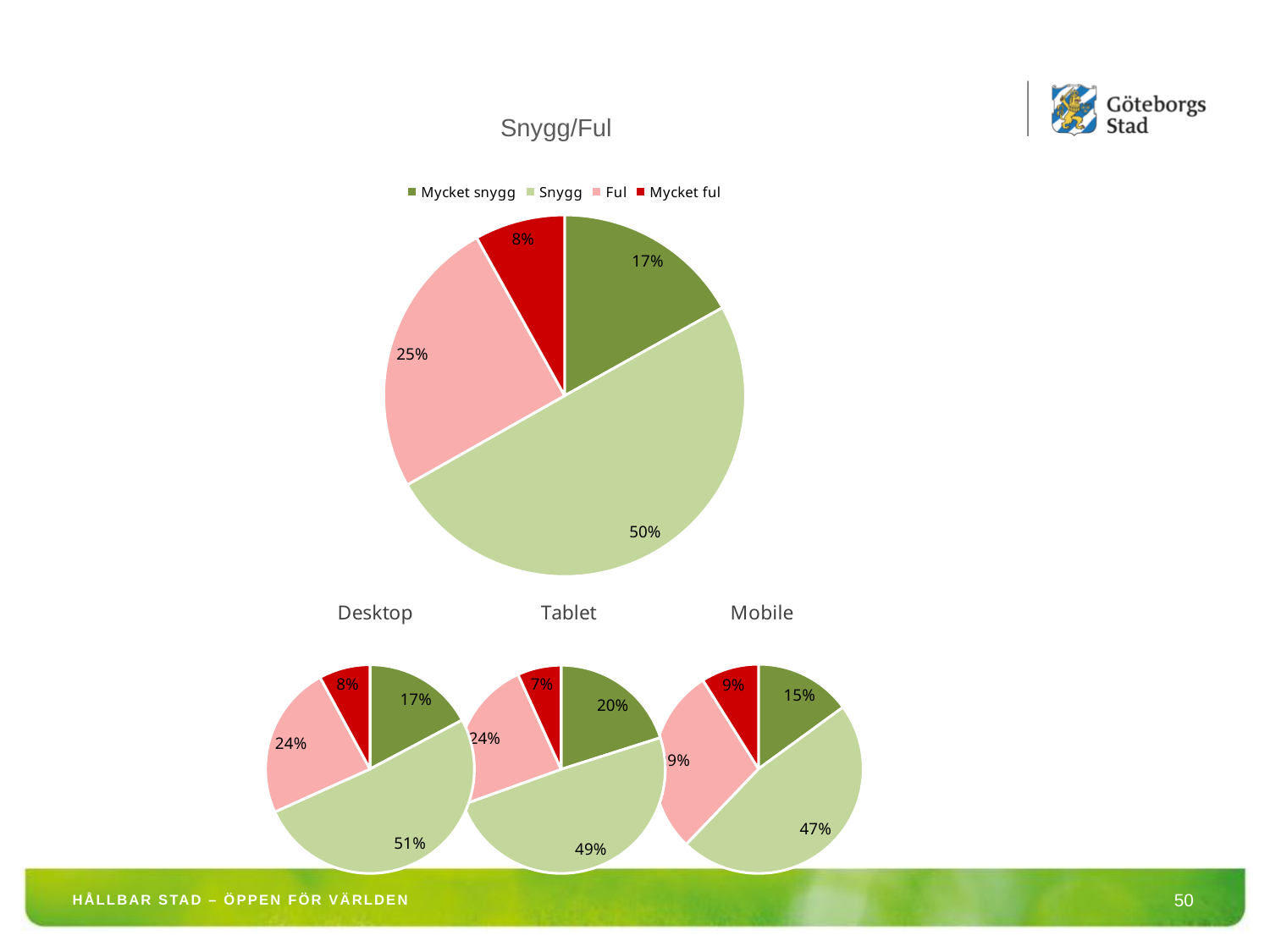
In the Mobile pie chart, what share does the Mycket ful slice have? 9% Which is larger: the Mycket snygg share in the Tablet pie chart or in the Mobile pie chart? Tablet In the main Snygg/Ful pie chart, which category has the smallest share? Mycket ful What kind of chart is the main Snygg/Ful chart? Pie chart In the main Snygg/Ful pie chart, what is the difference between the Ful share and the Mycket snygg share? 8% In the Tablet pie chart, what share does the Mycket snygg slice have? 20% How many categories does the legend of the Snygg/Ful chart list? 4 In the Desktop pie chart, what share does the Snygg slice have? 51% In the main Snygg/Ful pie chart, which category has the largest share? Snygg In the main Snygg/Ful pie chart, what share does the Snygg slice have? 50% In the main Snygg/Ful pie chart, what share does the Mycket ful slice have? 8% Which colour represents Mycket ful in the Snygg/Ful charts? Red